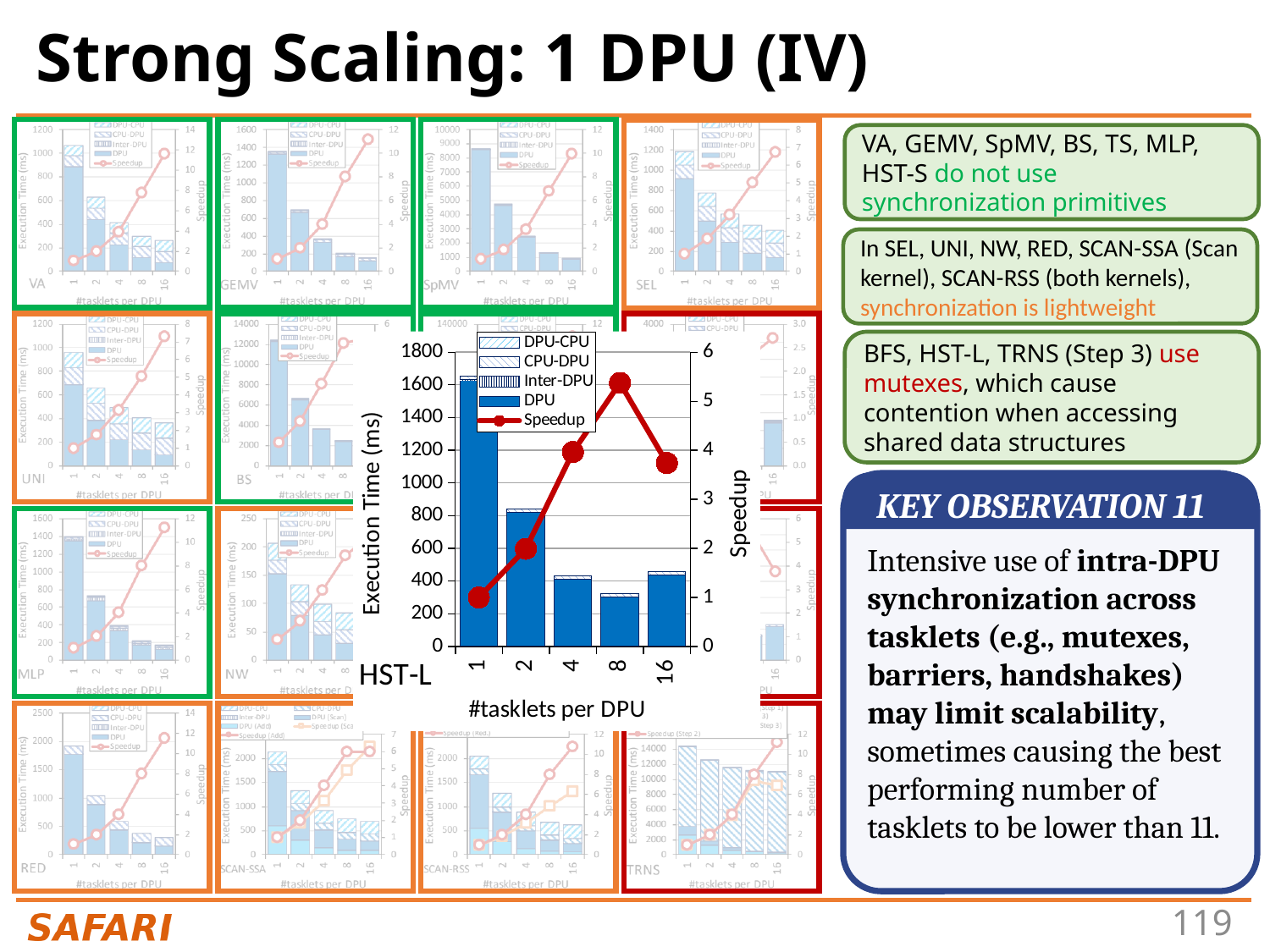
On the enlarged HST-L chart, is the execution time for 2 tasklets per DPU greater or less than 1000 ms? less On the enlarged HST-L chart, is the speedup for 8 tasklets per DPU greater or less than 5? greater On the enlarged HST-L chart, which has the larger execution time: 2 tasklets per DPU or 16 tasklets per DPU? 2 tasklets per DPU On the enlarged HST-L chart, which number of tasklets per DPU has the lowest execution time? 8 On the enlarged HST-L chart, which number of tasklets per DPU has the highest execution time? 1 On the enlarged HST-L chart, what kind of chart is it? bar chart with a line (speedup) On the enlarged HST-L chart, is the execution time for 1 tasklet per DPU greater or less than 1400 ms? greater On the enlarged HST-L chart, what is the label of the right-hand y axis? Speedup On the enlarged HST-L chart, does the speedup rise or fall from 8 to 16 tasklets per DPU? fall On the enlarged HST-L chart, how many values of #tasklets per DPU are shown on the x axis? 5 On the enlarged HST-L chart, how many series does the legend list? 5 On the enlarged HST-L chart, at which number of tasklets per DPU is the speedup highest? 8